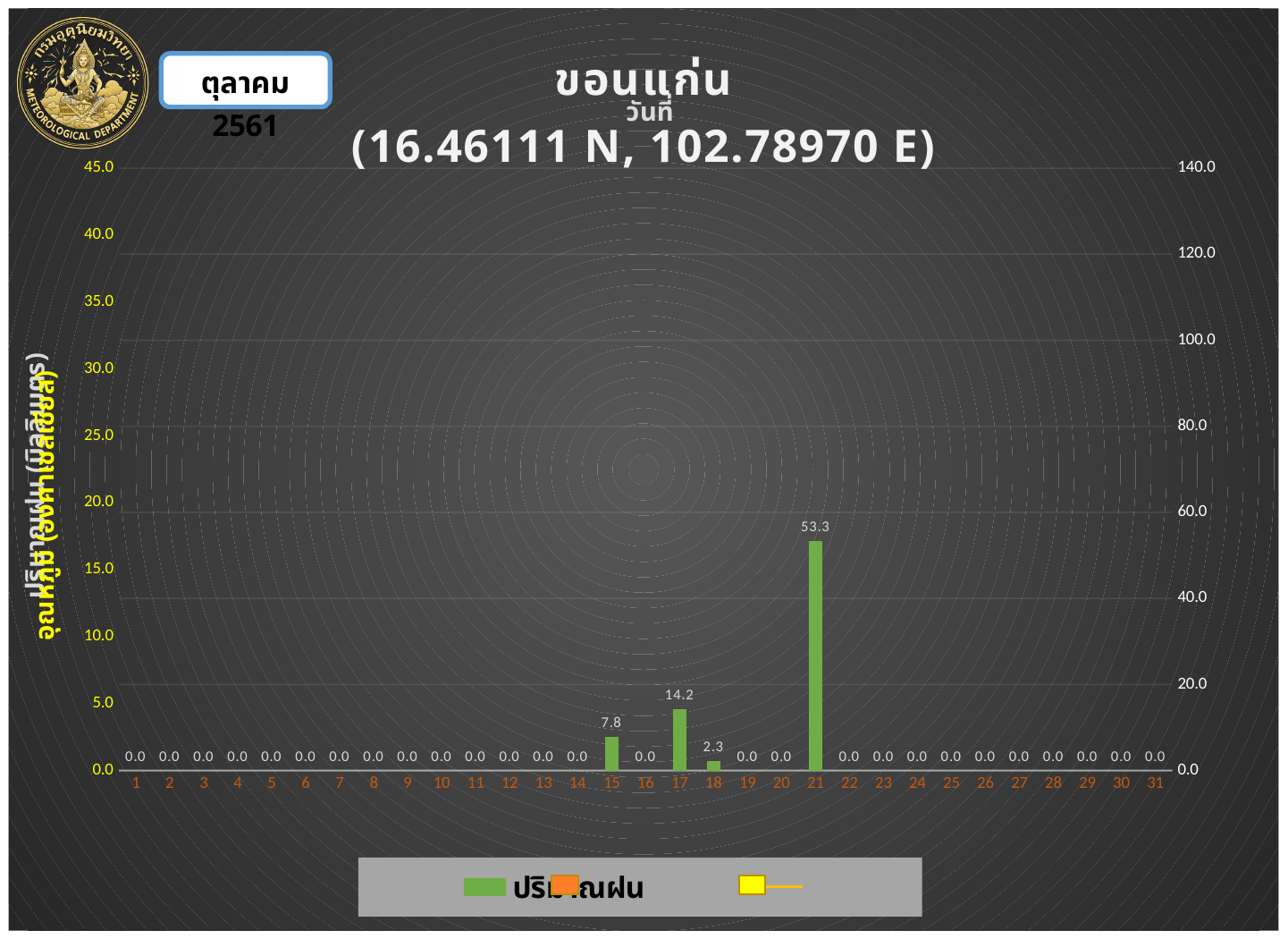
What is the rainfall value shown for day 21? 53.3 What is the difference between the rainfall values for day 15 and day 18? 5.5 What is the difference between the rainfall values for day 21 and day 17? 39.1 What is the rainfall value shown for day 15? 7.8 What is the rainfall value shown for day 18? 2.3 What is the rainfall value shown for day 10? 0.0 Which day has the highest rainfall value? 21 Is the value for day 21 greater or less than 60.0 on the right axis? less What kind of chart is shown on the slide? bar chart How many days are shown on the x axis? 31 Which day has the larger rainfall value, day 15 or day 17? 17 What is the rainfall value shown for day 17? 14.2